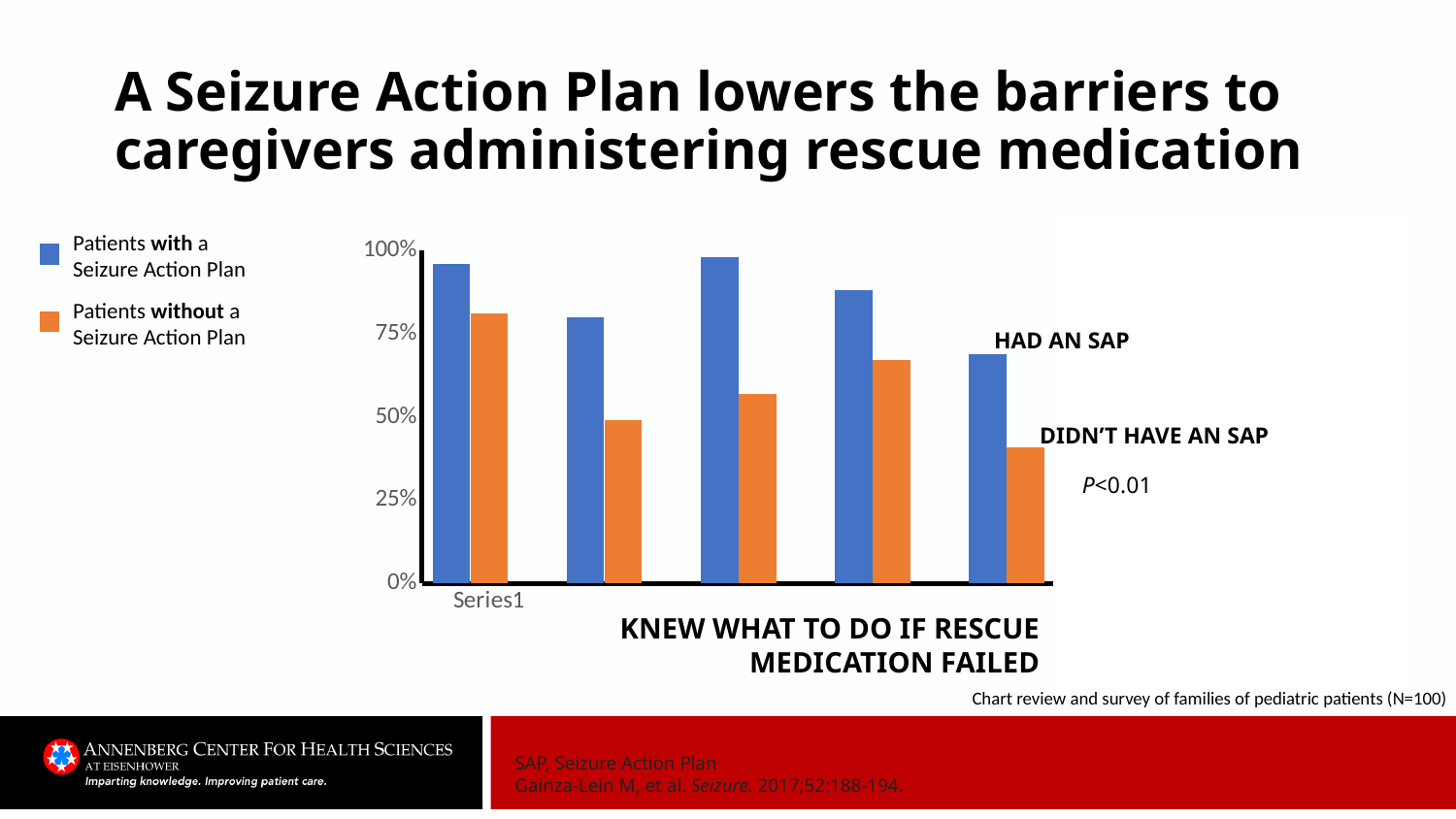
Which group of bars has the highest value for patients without a Seizure Action Plan? the first group (Series1) What kind of chart is shown on the slide? bar chart In the first group of bars (Series1), is the value for patients with a Seizure Action Plan greater or less than 75%? greater In the fifth (rightmost) group of bars, is the value for patients without a Seizure Action Plan greater or less than 50%? less Which group of bars has the lowest value for patients with a Seizure Action Plan? the fifth (rightmost) group In the fifth (rightmost) group of bars, is the value for patients with a Seizure Action Plan greater or less than 75%? less How many series does the legend list? 2 In the first group of bars (Series1), which is larger: the value for patients with a Seizure Action Plan or the value for patients without one? Patients with a Seizure Action Plan Which colour represents patients with a Seizure Action Plan? blue How many groups of bars are plotted in the chart? 5 What is the only category label printed on the x axis? Series1